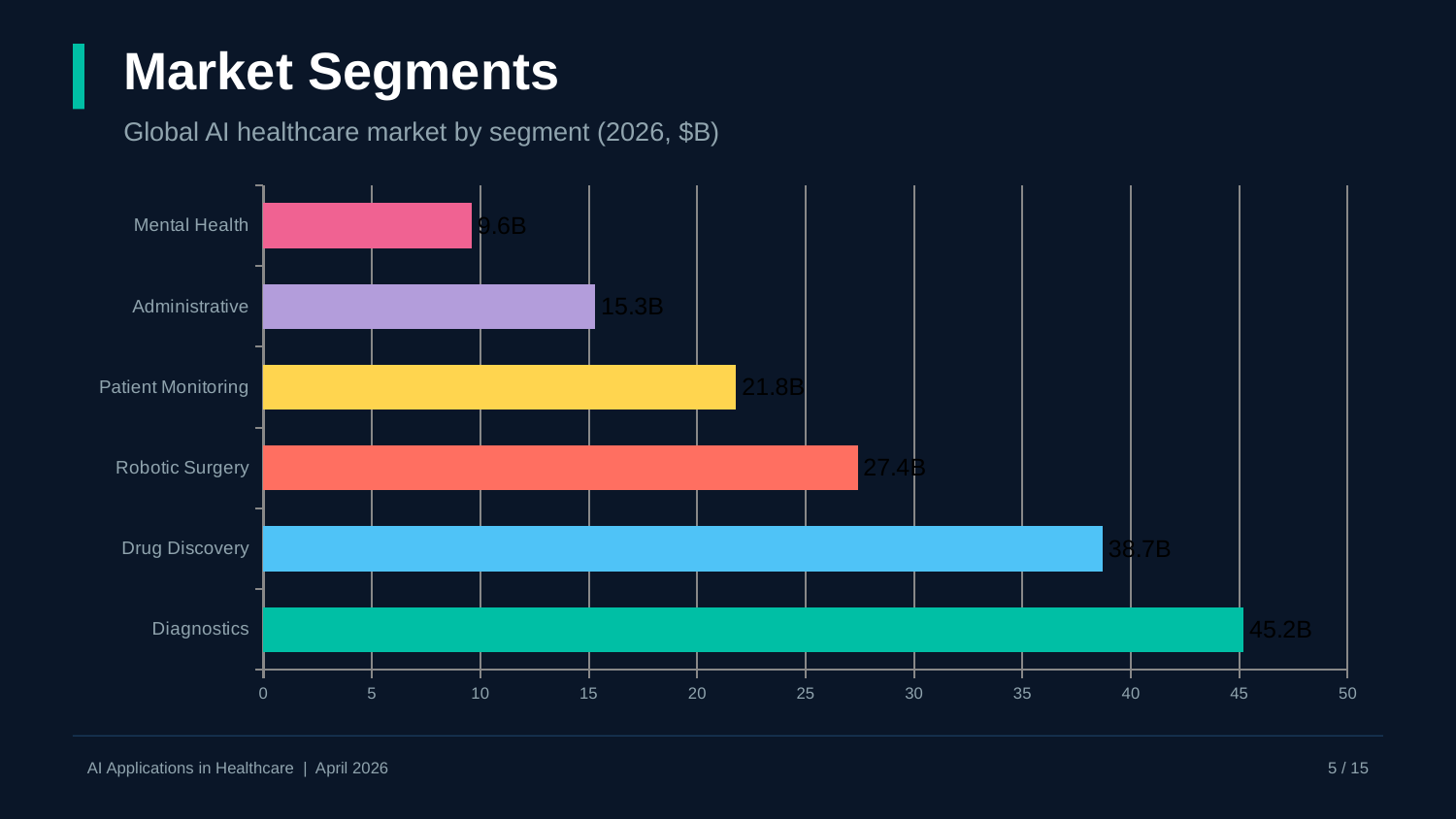
Which is larger, the value for Robotic Surgery or the value for Patient Monitoring? Robotic Surgery What is the difference between the values for Diagnostics and Drug Discovery? 6.5B Is the value for Mental Health greater or less than 10? less What is the value for Diagnostics? 45.2B What is the value for Administrative? 15.3B What is the value for Drug Discovery? 38.7B What is the value for Patient Monitoring? 21.8B What is the value for Robotic Surgery? 27.4B What type of chart is shown on the slide? bar chart Which segment has the highest value? Diagnostics How many segments are shown in the chart? 6 Which segment has the lowest value? Mental Health